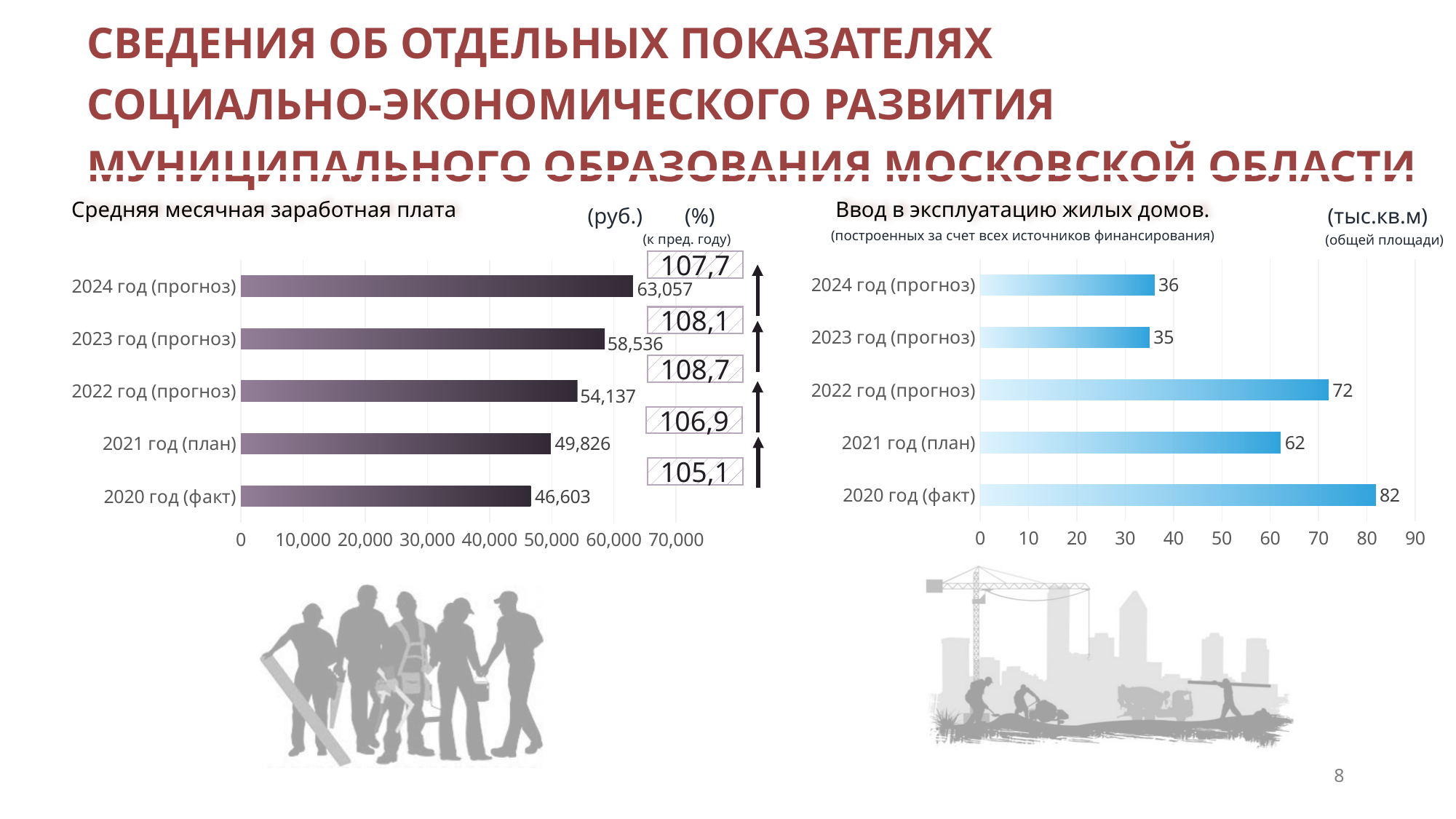
In the 'Ввод в эксплуатацию жилых домов' chart, what is the difference between the values for 2020 год (факт) and 2024 год (прогноз)? 46 In the 'Средняя месячная заработная плата' chart, what percentage (к пред. году) is shown next to 2022 год (прогноз)? 108,7 In the 'Средняя месячная заработная плата' chart, which category has the lowest value? 2020 год (факт) In the 'Средняя месячная заработная плата' chart, how many categories are plotted? 5 In the 'Ввод в эксплуатацию жилых домов' chart, which is larger: the value for 2022 год (прогноз) or 2021 год (план)? 2022 год (прогноз) What unit is shown for the 'Ввод в эксплуатацию жилых домов' chart? тыс.кв.м In the 'Средняя месячная заработная плата' chart, what is the value for 2020 год (факт)? 46,603 In the 'Ввод в эксплуатацию жилых домов' chart, what is the value for 2021 год (план)? 62 In the 'Ввод в эксплуатацию жилых домов' chart, which category has the highest value? 2020 год (факт) What type of chart is the 'Ввод в эксплуатацию жилых домов' chart? Bar chart In the 'Средняя месячная заработная плата' chart, what is the value for 2024 год (прогноз)? 63,057 In the 'Средняя месячная заработная плата' chart, what is the difference between the values for 2024 год (прогноз) and 2023 год (прогноз)? 4,521